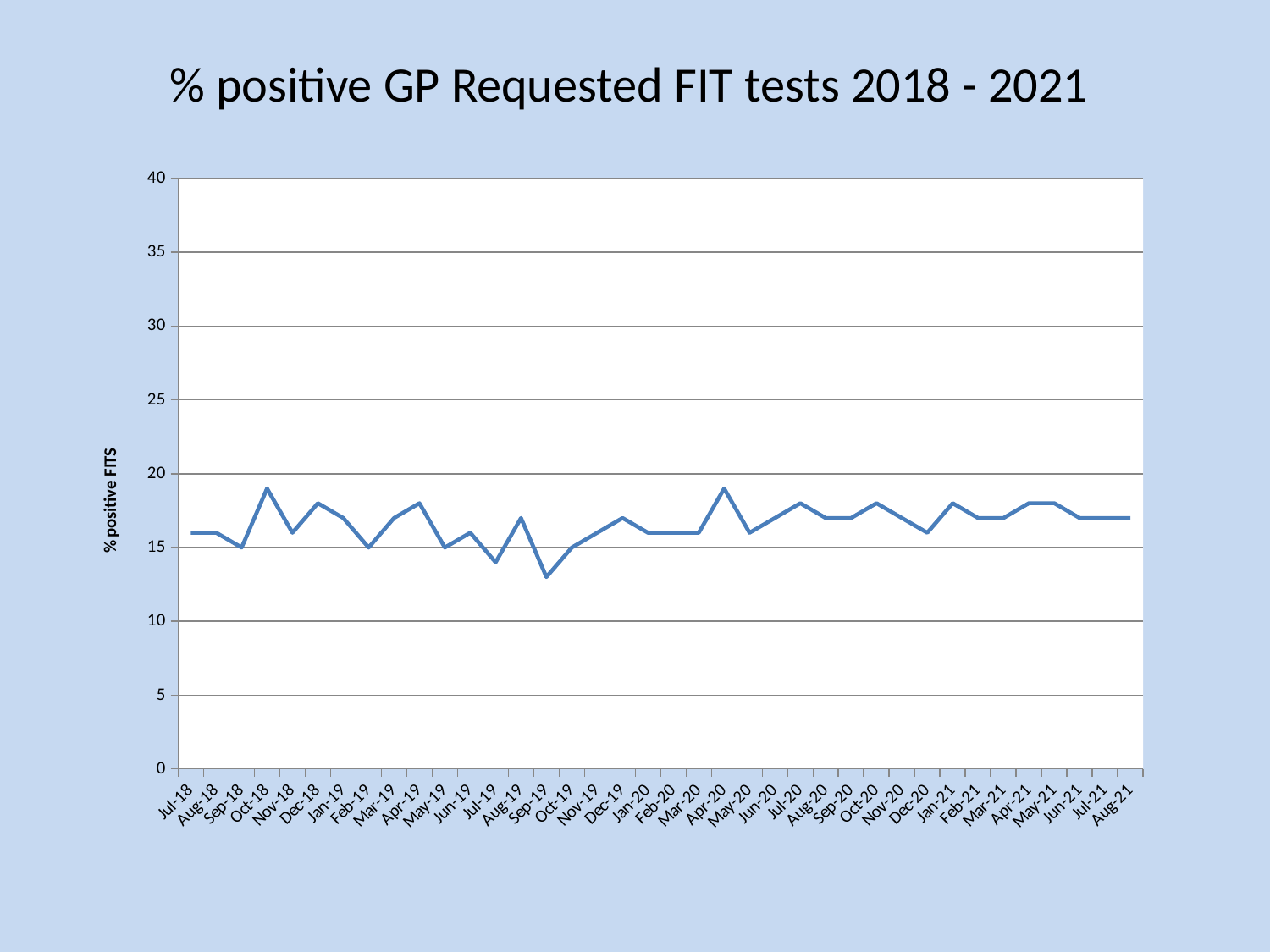
What kind of chart is shown on the slide? line chart Is the value for Jul-19 greater or less than 15? less Is the value for Oct-18 greater or less than 15? greater What is the label on the vertical axis of the chart? % positive FITS How many monthly data points are plotted on the chart? 38 Does the value rise or fall from Apr-20 to May-20? fall Which is larger, the value for Sep-19 or the value for Apr-20? Apr-20 Which is larger, the value for Sep-18 or the value for Oct-18? Oct-18 Is the value for Sep-19 greater or less than 15? less What is the title of the chart? % positive GP Requested FIT tests 2018 - 2021 Which month has the lowest % positive FITS value? Sep-19